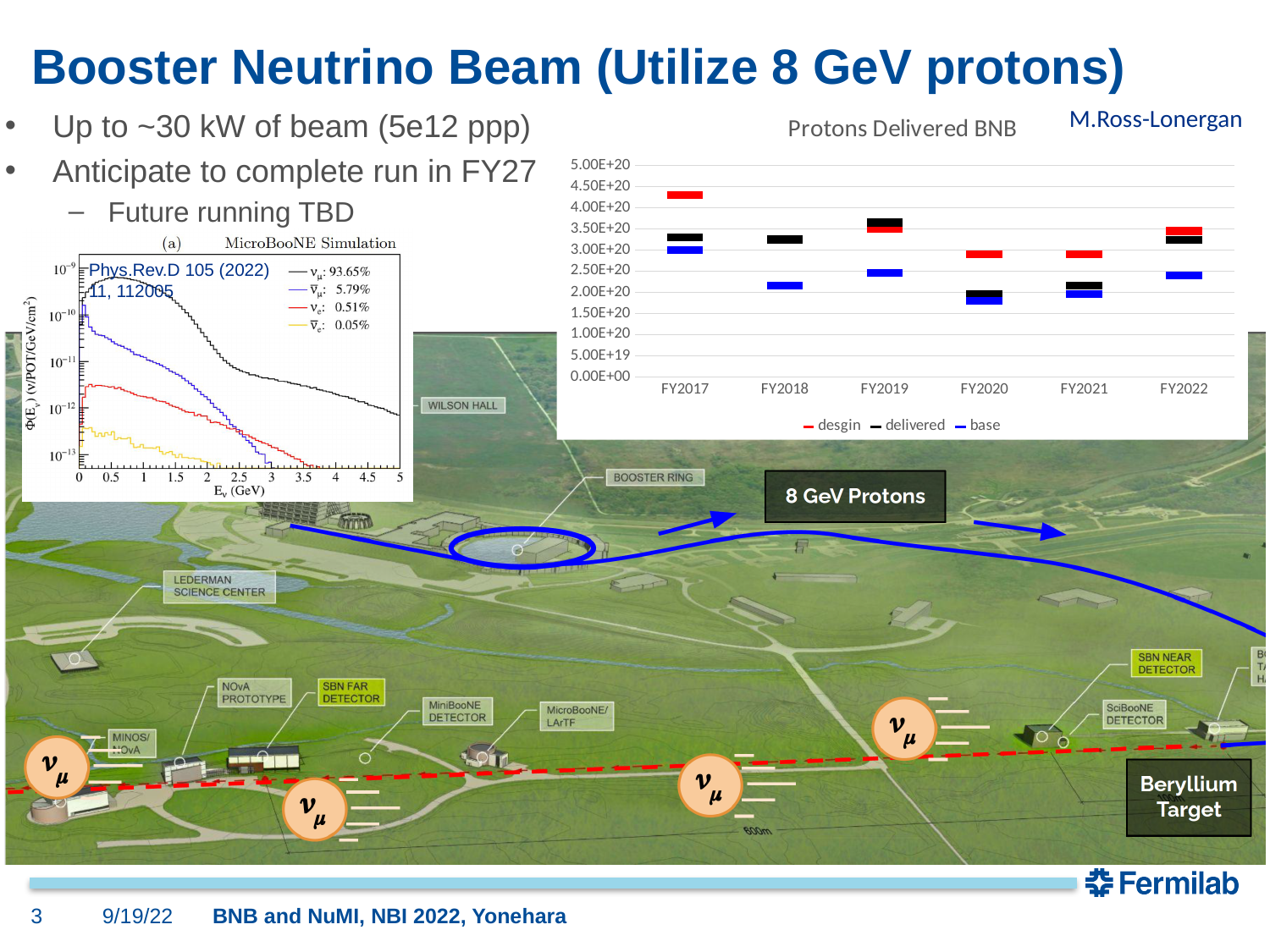
In the 'Protons Delivered BNB' chart, which is larger, the delivered value for FY2019 or for FY2020? FY2019 In the 'Protons Delivered BNB' chart, how many series does the legend list? 3 In the 'Protons Delivered BNB' chart, which is larger, the base value for FY2017 or for FY2021? FY2017 In the 'Protons Delivered BNB' chart, is the delivered value for FY2020 greater or less than 2.50E+20? less In the MicroBooNE Simulation chart on the left, what percentage is listed in the legend for the ν_μ component? 93.65% In the 'Protons Delivered BNB' chart, how many fiscal years are shown on the x axis? 6 In the 'Protons Delivered BNB' chart, is the base value for FY2018 greater or less than 2.50E+20? less In the 'Protons Delivered BNB' chart, which fiscal year has the highest desgin value? FY2017 In the 'Protons Delivered BNB' chart, is the desgin value for FY2017 greater or less than 4.00E+20? greater In the 'Protons Delivered BNB' chart, what are the three legend entries? desgin, delivered, base In the 'Protons Delivered BNB' chart, which is larger, the desgin value for FY2017 or for FY2022? FY2017